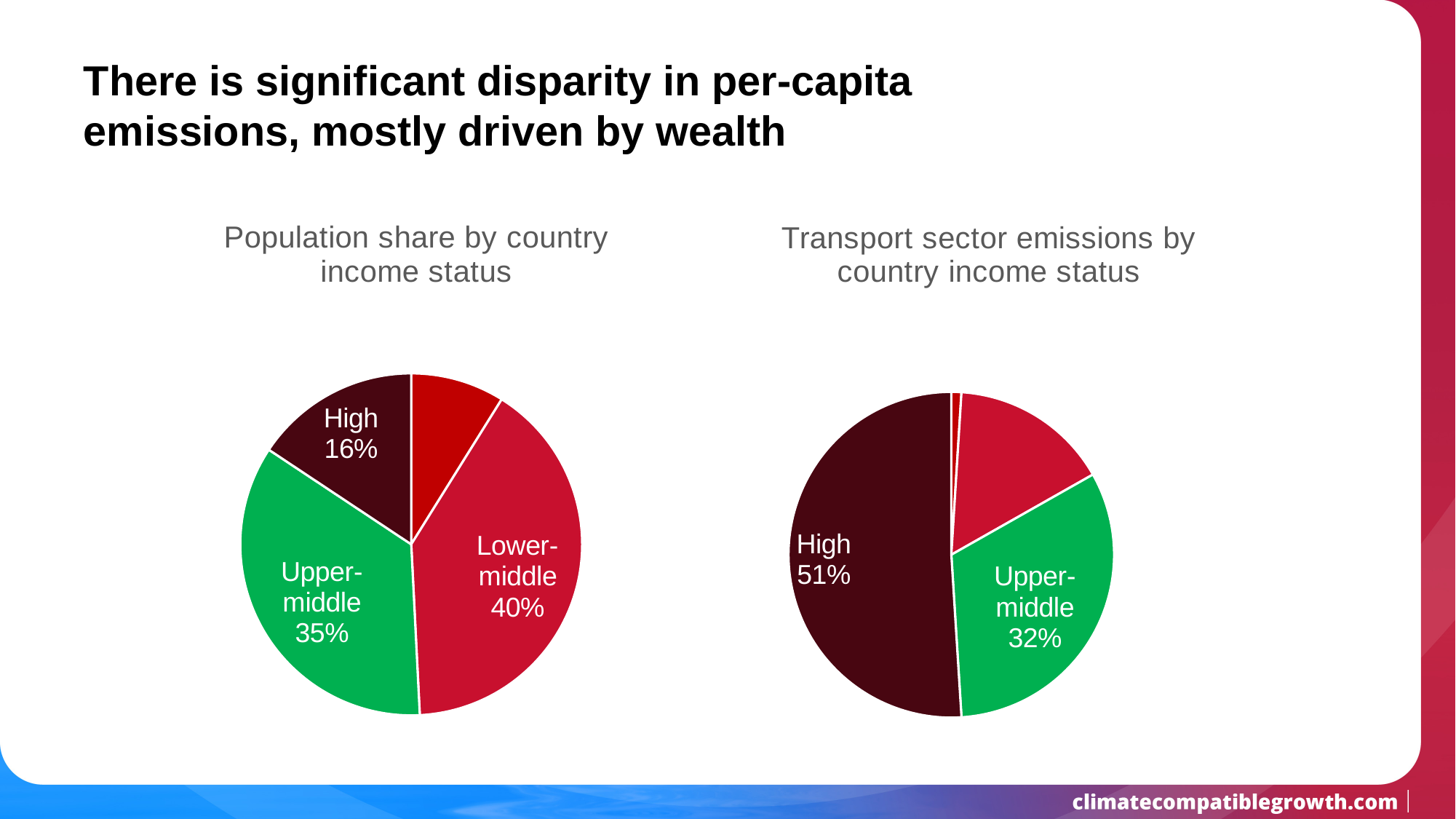
In the 'Population share by country income status' pie chart, what share is shown for the High income group? 16% In the 'Population share by country income status' pie chart, what share is shown for Lower-middle? 40% In the 'Population share by country income status' pie chart, which labelled income group has the largest slice? Lower-middle In the 'Population share by country income status' pie chart, what share is shown for Upper-middle? 35% In the 'Transport sector emissions by country income status' pie chart, which income group has the largest slice? High Is the High income group's share larger in the 'Population share by country income status' chart or in the 'Transport sector emissions by country income status' chart? Transport sector emissions by country income status What type of chart is used for 'Population share by country income status'? Pie chart In the 'Transport sector emissions by country income status' pie chart, what share is shown for the High income group? 51% In the 'Population share by country income status' pie chart, how many percentage points larger is the Lower-middle share than the Upper-middle share? 5 percentage points In the 'Transport sector emissions by country income status' pie chart, what share is shown for Upper-middle? 32% How many slices does the 'Transport sector emissions by country income status' pie chart have? 4 In the 'Transport sector emissions by country income status' pie chart, how many percentage points larger is the High share than the Upper-middle share? 19 percentage points